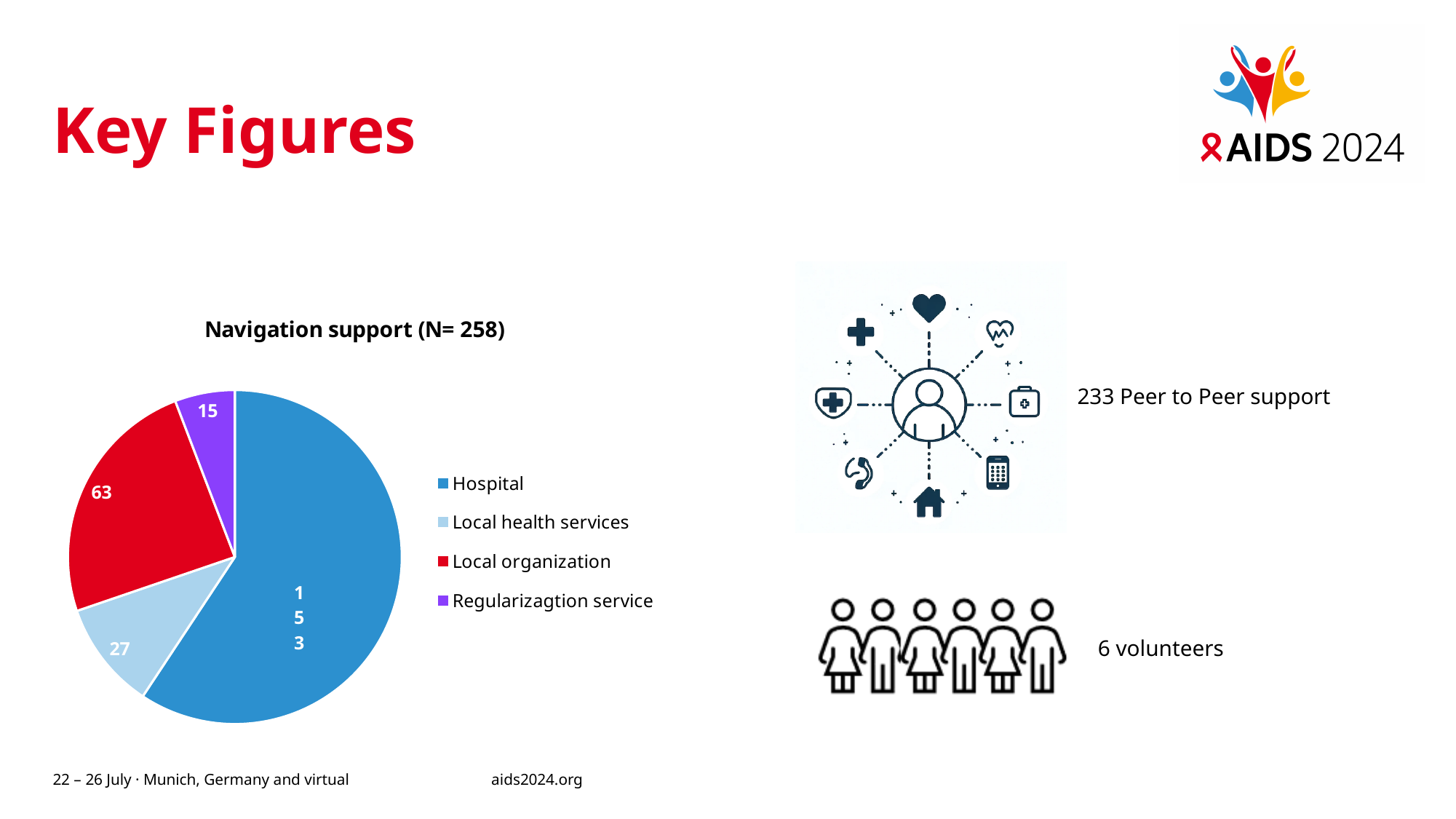
What is the total N stated in the title of the Navigation support pie chart? 258 Which category has the smallest slice in the Navigation support pie chart? Regularizagtion service In the Navigation support pie chart, what is the value for Hospital? 153 In the Navigation support pie chart, which is larger: Local organization or Local health services? Local organization In the Navigation support pie chart, what is the difference between the Local organization and Local health services values? 36 Which category has the largest slice in the Navigation support pie chart? Hospital In the Navigation support pie chart, what is the value for Local organization? 63 What type of chart is shown under the title "Navigation support (N= 258)"? Pie chart In the Navigation support pie chart, what is the value for Regularizagtion service? 15 In the Navigation support pie chart, what colour is the Local organization slice? Red In the Navigation support pie chart, what is the value for Local health services? 27 How many categories does the Navigation support pie chart show? 4